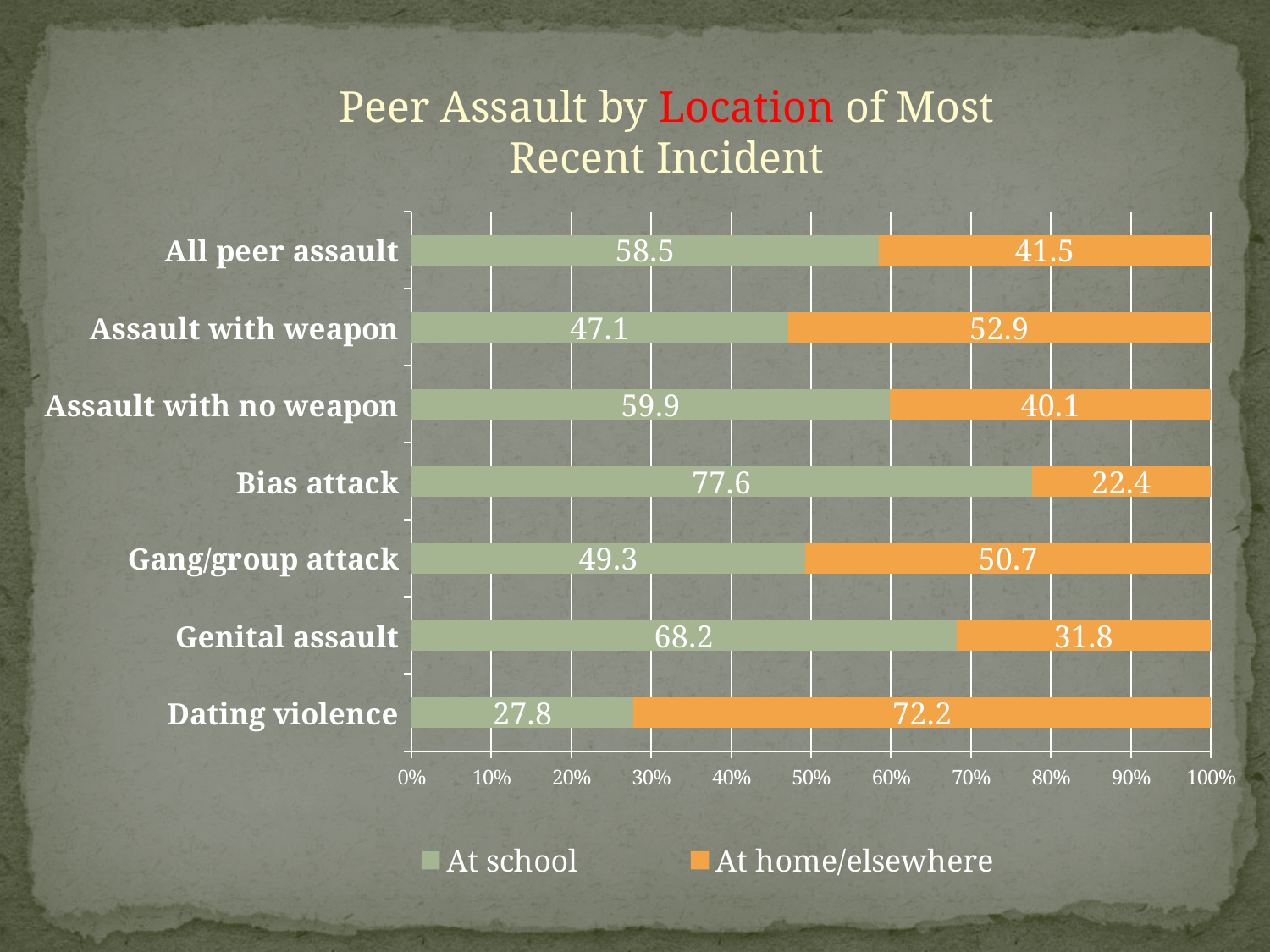
What is the 'At home/elsewhere' value for Dating violence? 72.2 What kind of chart is shown on the slide? Stacked bar chart What is the total of the stacked bar for Gang/group attack? 100 Which category has the lowest 'At school' value? Dating violence Which category has the highest 'At school' value? Bias attack How many categories are shown on the chart? 7 What is the 'At school' value for Bias attack? 77.6 What is the difference between the 'At school' and 'At home/elsewhere' values for Genital assault? 36.4 What is the title of the chart? Peer Assault by Location of Most Recent Incident What is the 'At school' value for All peer assault? 58.5 Which is larger for Assault with weapon: the 'At school' value or the 'At home/elsewhere' value? At home/elsewhere How many series does the legend list? 2